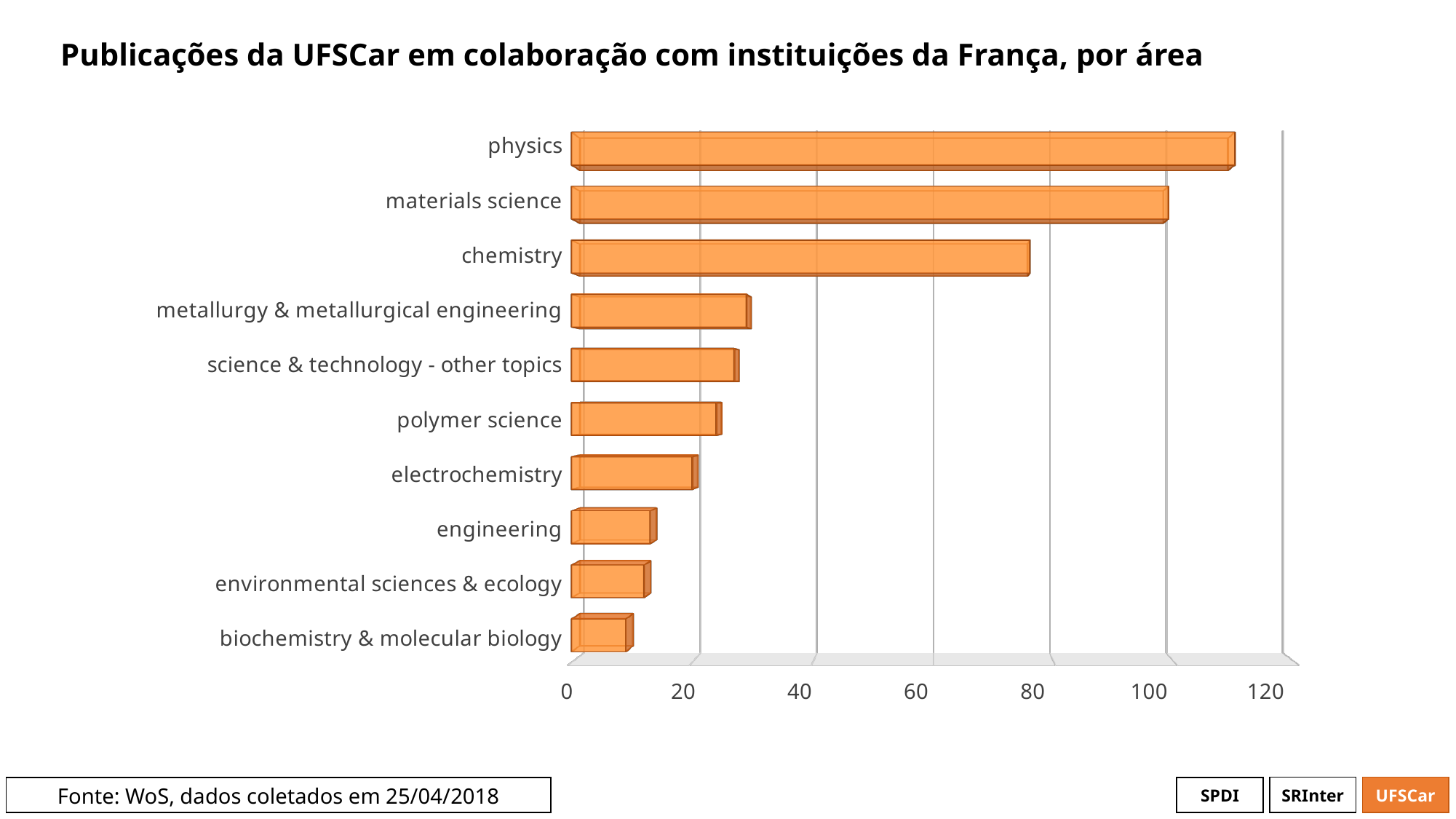
What kind of chart is shown on the slide? bar chart How many areas (categories) are plotted in the chart? 10 Is the value for physics greater or less than 100? greater Is the value for engineering greater or less than 20? less Which has more publications, metallurgy & metallurgical engineering or engineering? metallurgy & metallurgical engineering Is the value for electrochemistry greater or less than 40? less Which area has the highest number of publications? physics What is the title of the chart? Publicações da UFSCar em colaboração com instituições da França, por área Which has more publications, physics or chemistry? physics Which area has the lowest number of publications? biochemistry & molecular biology